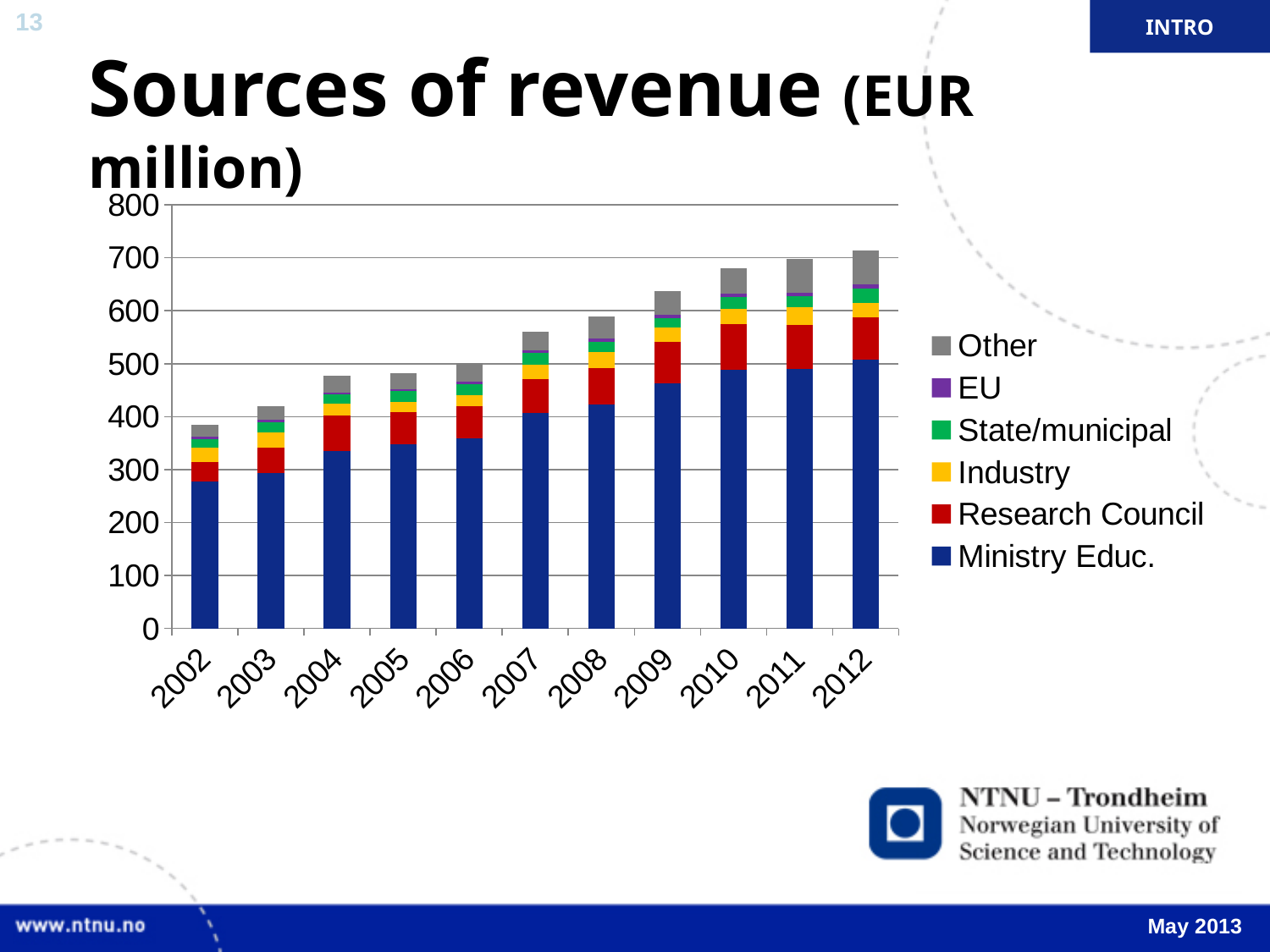
Which year has the lowest total revenue? 2002 What kind of chart is shown on the slide? Stacked bar chart Do total revenues generally rise or fall from 2002 to 2012? Rise Which year has the highest total revenue? 2012 Which series forms the bottom segment of each bar? Ministry Educ. Is the total revenue for 2002 greater or less than 400? less How many series does the legend list? 6 In what unit are the revenues in the chart expressed, according to the title? EUR million How many years are shown on the x axis of the chart? 11 Is the total revenue for 2012 greater or less than 700? greater Which year has the larger total revenue, 2007 or 2010? 2010